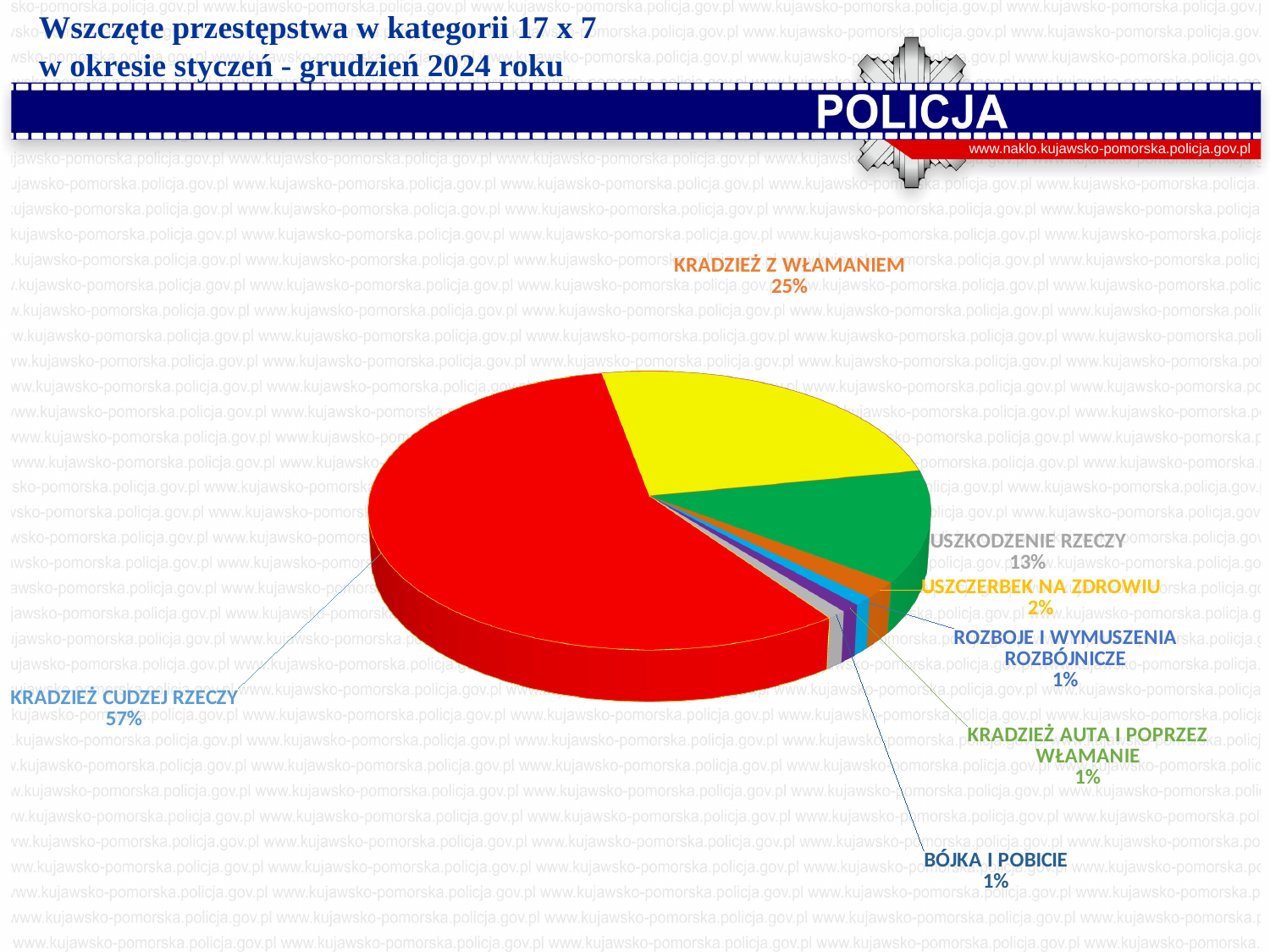
What share of the pie does USZCZERBEK NA ZDROWIU have? 2% What kind of chart is shown on the slide? pie chart What is the difference in percentage points between KRADZIEŻ CUDZEJ RZECZY and KRADZIEŻ Z WŁAMANIEM? 32 What is the combined share of KRADZIEŻ Z WŁAMANIEM and USZKODZENIE RZECZY? 38% What share of the pie does KRADZIEŻ Z WŁAMANIEM have? 25% What share of the pie does BÓJKA I POBICIE have? 1% How many categories are shown in the pie chart? 7 What period does the chart title say the data covers? styczeń - grudzień 2024 roku Which has a larger share, USZKODZENIE RZECZY or USZCZERBEK NA ZDROWIU? USZKODZENIE RZECZY Which category has the largest share of the pie? KRADZIEŻ CUDZEJ RZECZY